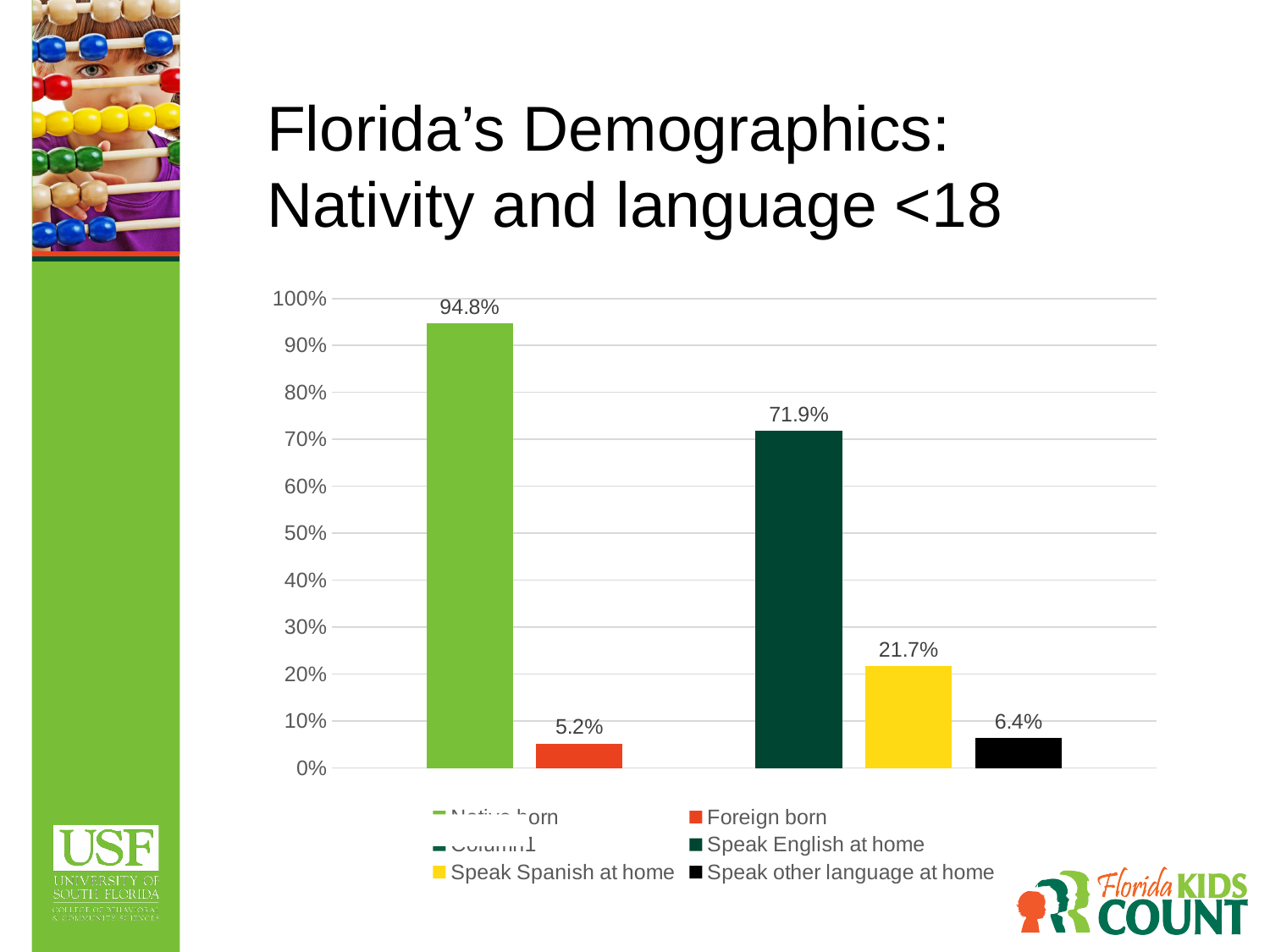
How many bars are plotted in the chart? 5 What is the value for Foreign born? 5.2% What colour is the bar for Speak Spanish at home? Yellow What is the value shown on the tallest bar in the chart? 94.8% What kind of chart is shown on the slide? Bar chart What is the difference between Speak English at home and Speak Spanish at home? 50.2 percentage points What is the difference between Speak other language at home and Foreign born? 1.2 percentage points What is the value for Speak other language at home? 6.4% Which category has the lowest value in the chart? Foreign born What is the value for Speak Spanish at home? 21.7% Which is larger, Speak Spanish at home or Speak other language at home? Speak Spanish at home What is the value for Speak English at home? 71.9%